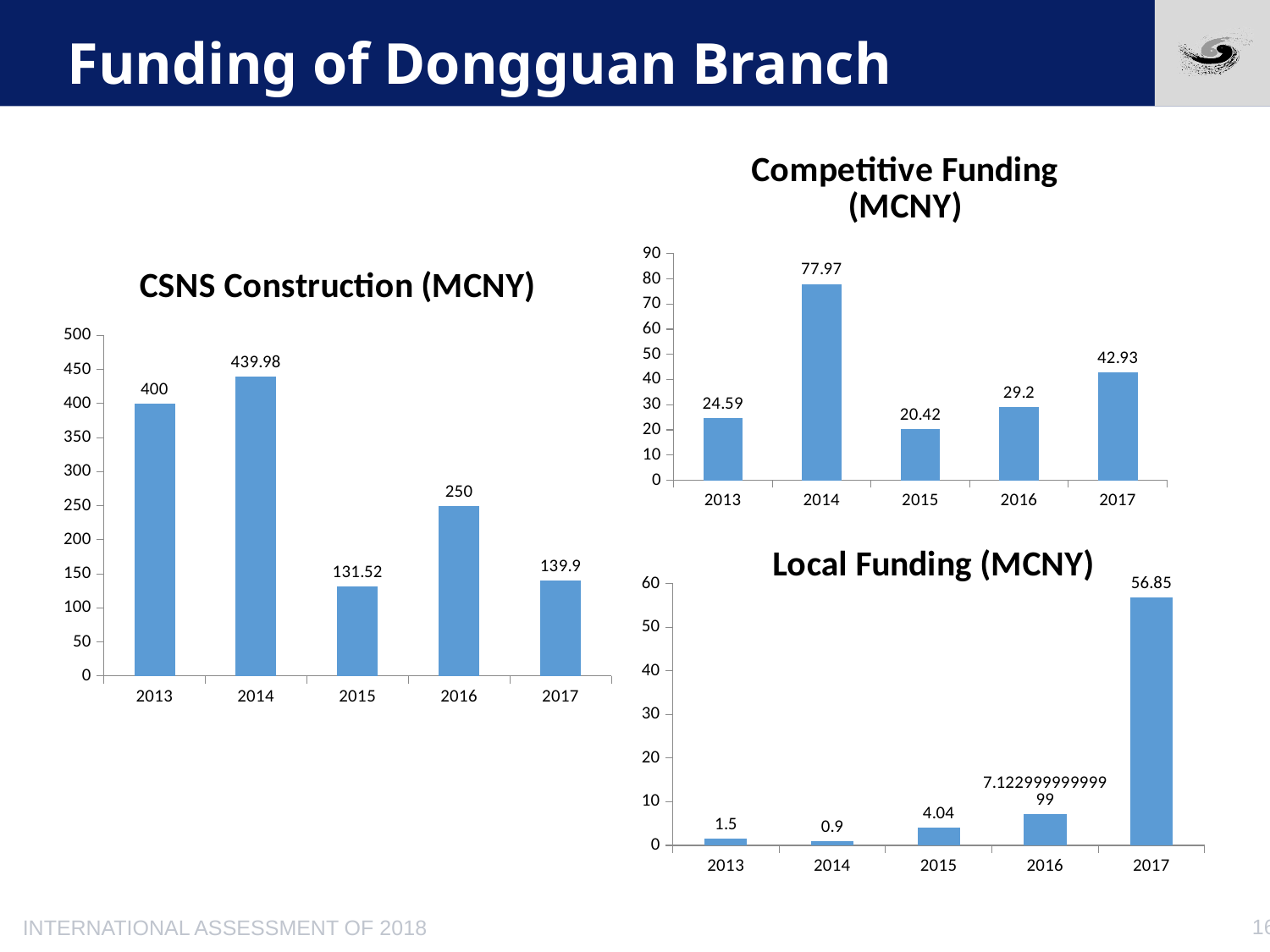
In the CSNS Construction (MCNY) chart, which year has the lowest value? 2015 In the Competitive Funding (MCNY) chart, what is the value for 2016? 29.2 In the CSNS Construction (MCNY) chart, what is the difference between the 2013 and 2016 values? 150 In the Local Funding (MCNY) chart, which year has the lowest value? 2014 How many years are shown on the x axis of the Local Funding (MCNY) chart? 5 How many charts are shown on the slide? 3 In the Local Funding (MCNY) chart, what is the value for 2017? 56.85 In the Local Funding (MCNY) chart, what is the difference between the 2015 and 2013 values? 2.54 What kind of chart is the CSNS Construction (MCNY) chart? Bar chart In the Competitive Funding (MCNY) chart, which year has the highest value? 2014 In the CSNS Construction (MCNY) chart, what is the value for 2014? 439.98 In the Competitive Funding (MCNY) chart, which is larger, the value for 2013 or the value for 2015? 2013